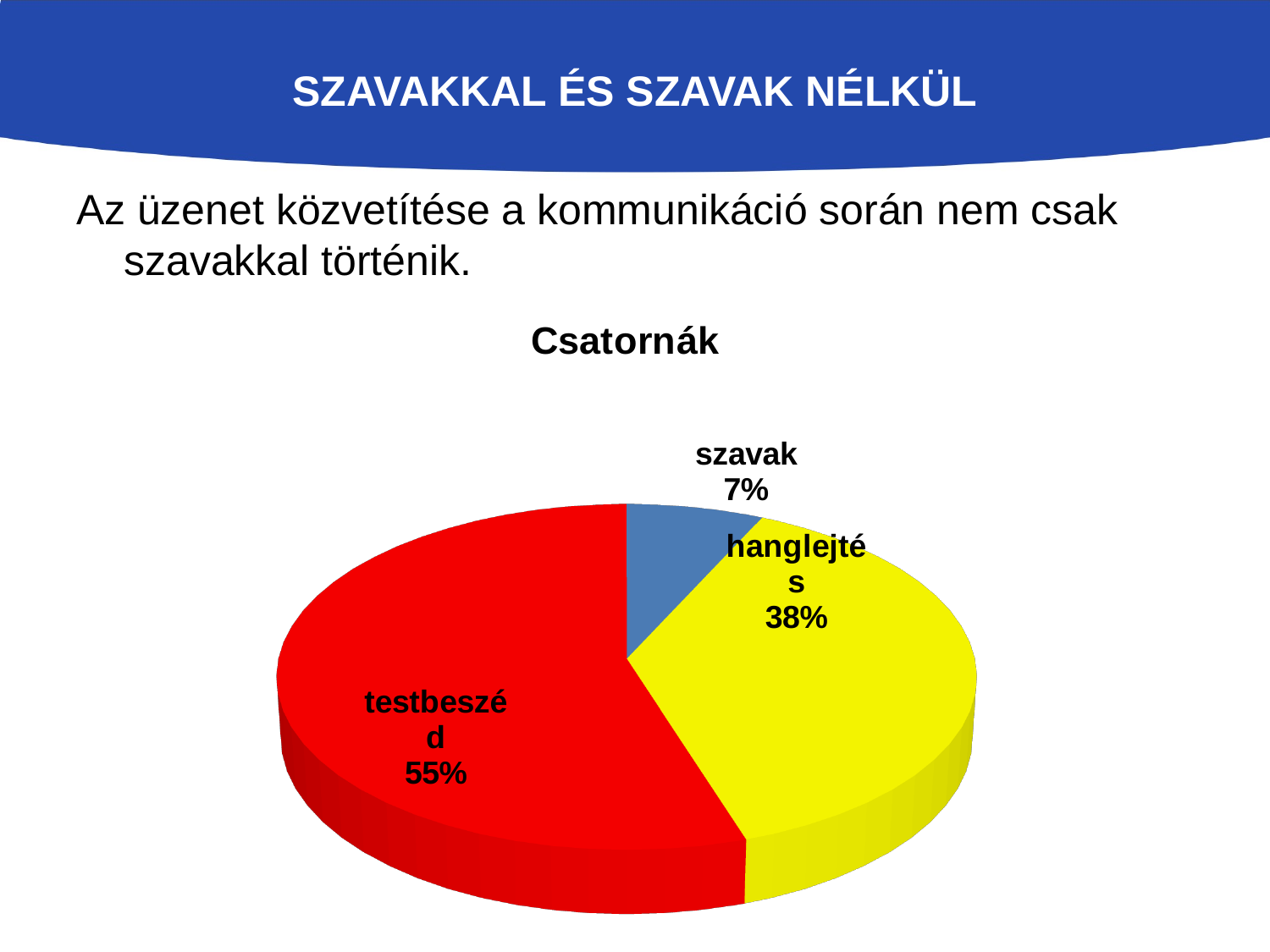
Which is larger, the share for "hanglejtés" or the share for "szavak"? hanglejtés What colour is the "testbeszéd" slice? red What share of the pie does "hanglejtés" have? 38% What is the title of the chart? Csatornák What kind of chart is shown under the title "Csatornák"? pie chart What share of the pie does "testbeszéd" have? 55% Which slice of the pie is the smallest? szavak What share of the pie does "szavak" have? 7% What is the difference in percentage points between "hanglejtés" and "szavak"? 31 What is the difference in percentage points between "testbeszéd" and "hanglejtés"? 17 Which slice of the pie is the largest? testbeszéd How many slices does the pie chart have? 3